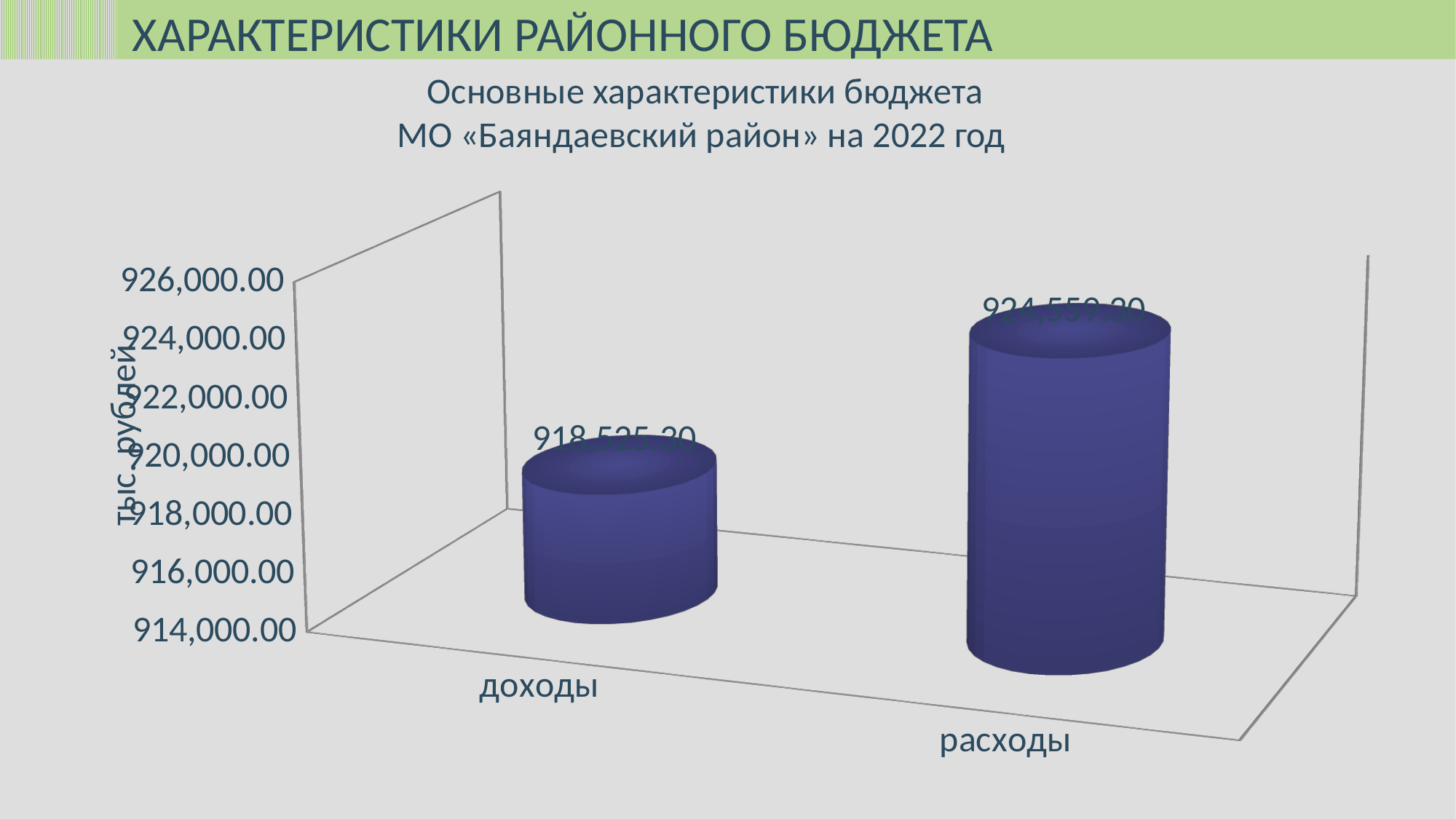
Which category has the highest value? расходы Which category has the lowest value? доходы Is the value for расходы greater or less than 922,000.00? greater What is the value for расходы? 924,559.30 Which is larger, the value for доходы or the value for расходы? расходы What unit is shown on the vertical axis label? тыс. рублей Is the value for доходы greater or less than 920,000.00? less What kind of chart is shown on the slide? bar chart What is the title of the chart? Основные характеристики бюджета МО «Баяндаевский район» на 2022 год How many categories are shown on the chart? 2 What is the difference between the values for расходы and доходы? 6,034.00 What is the value for доходы? 918,525.30